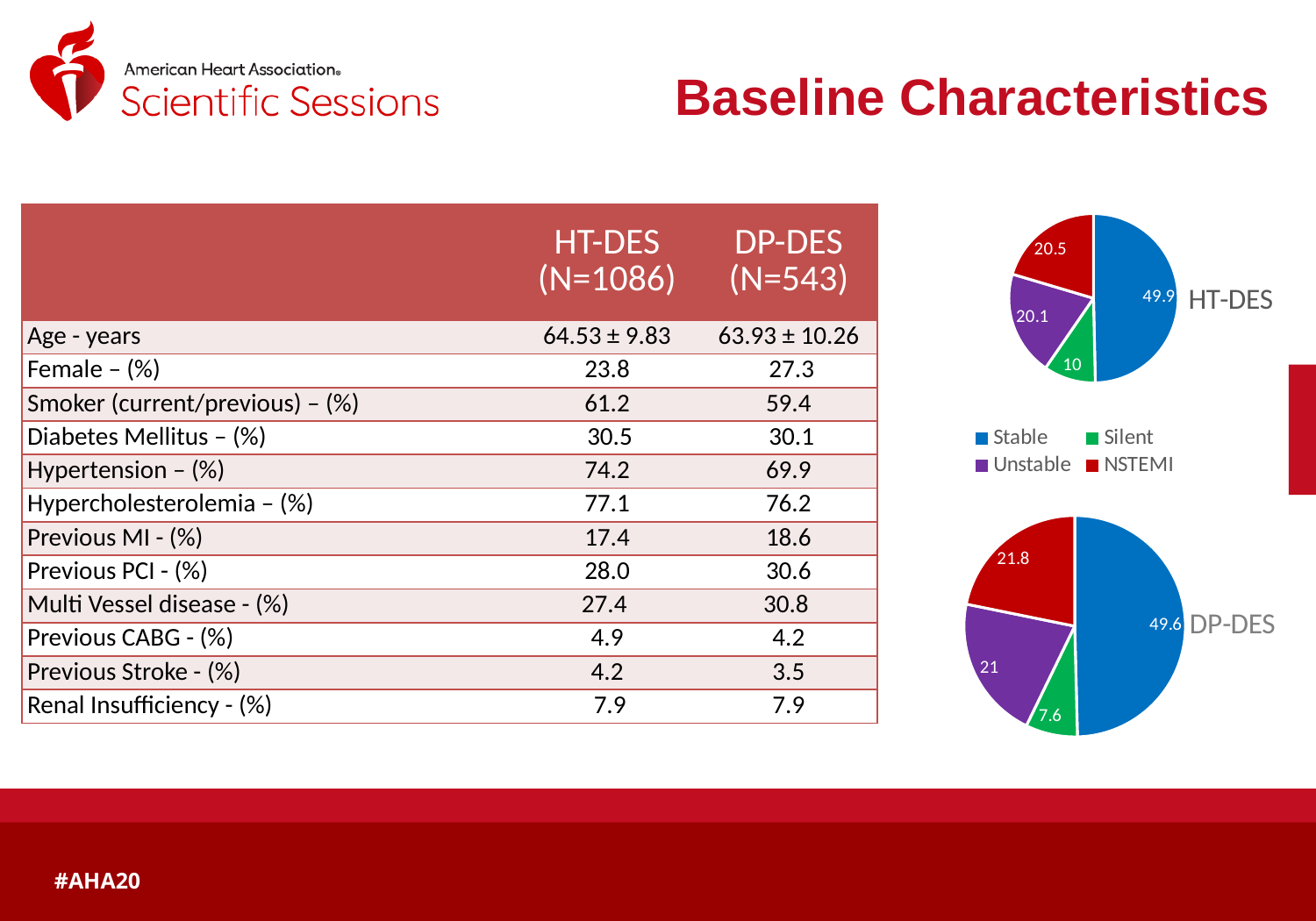
In the legend for the pie charts, which category is shown in red? NSTEMI How many slices does the DP-DES pie chart have? 4 In the DP-DES pie chart, what is the value for NSTEMI? 21.8 In the HT-DES pie chart, which is larger, the NSTEMI slice or the Silent slice? NSTEMI In the HT-DES pie chart, what is the value for Stable? 49.9 In the DP-DES pie chart, what is the difference between the Stable and Silent values? 42 How many entries does the legend between the two pie charts list? 4 In the HT-DES pie chart, which category has the largest slice? Stable What kind of chart is the HT-DES chart? Pie chart In the DP-DES pie chart, which category has the smallest slice? Silent In the DP-DES pie chart, what is the value for Unstable? 21 In the HT-DES pie chart, what is the value for Silent? 10